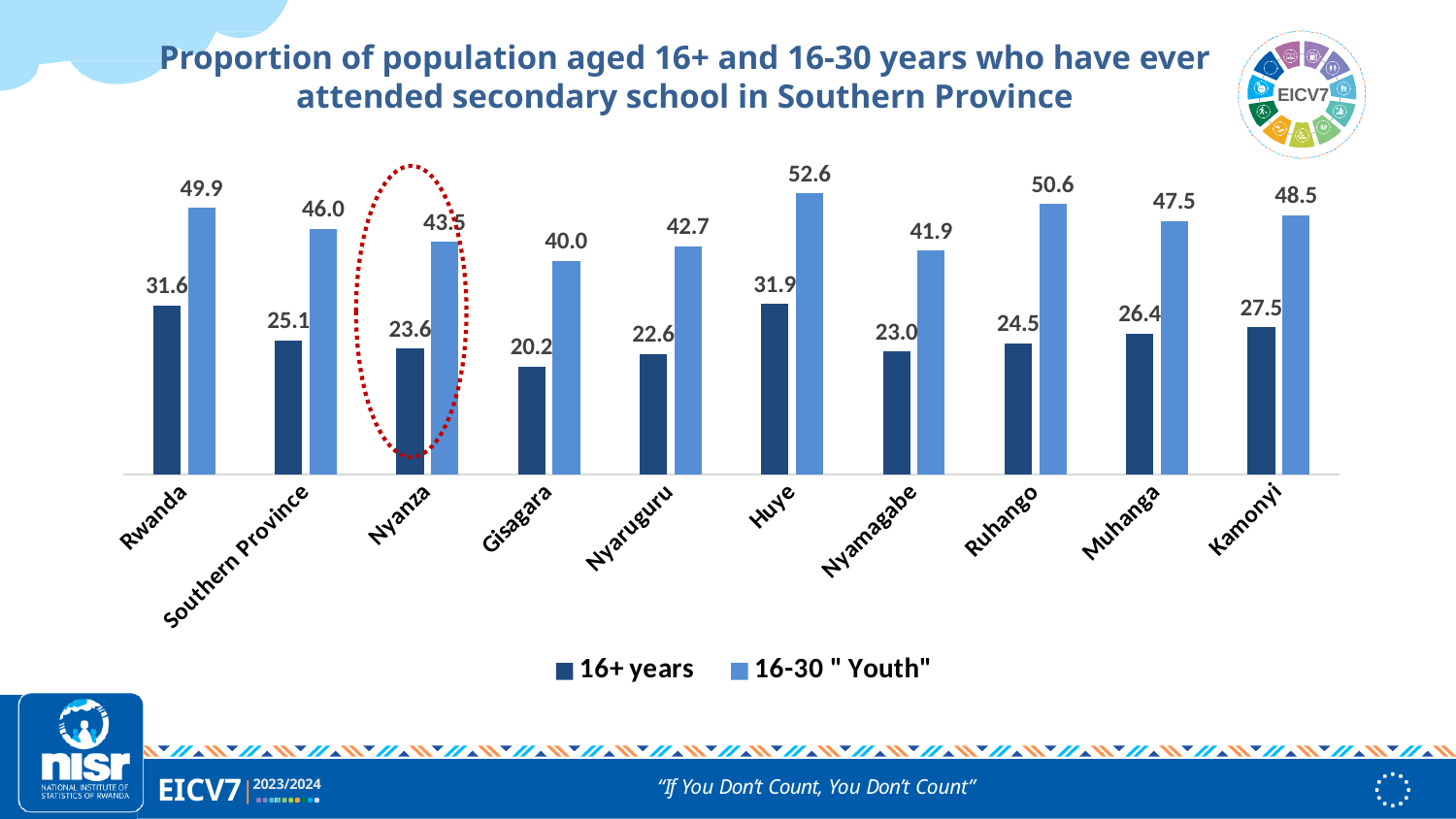
What is the difference between the 16-30 "Youth" value and the 16+ years value for Nyanza? 19.9 Which category has the lowest value in the 16+ years series? Gisagara What is the difference between the 16-30 "Youth" values for Rwanda and Southern Province? 3.9 How many series does the legend list? 2 What kind of chart is shown on the slide? Bar chart Which is larger, the 16-30 "Youth" value for Ruhango or for Muhanga? Ruhango How many categories are shown on the x axis? 10 Which category has the highest value in the 16-30 "Youth" series? Huye What is the value for the 16+ years series for Nyanza? 23.6 What is the value for the 16-30 "Youth" series for Huye? 52.6 Which category is highlighted with a red dotted circle? Nyanza What is the value for the 16+ years series for Rwanda? 31.6